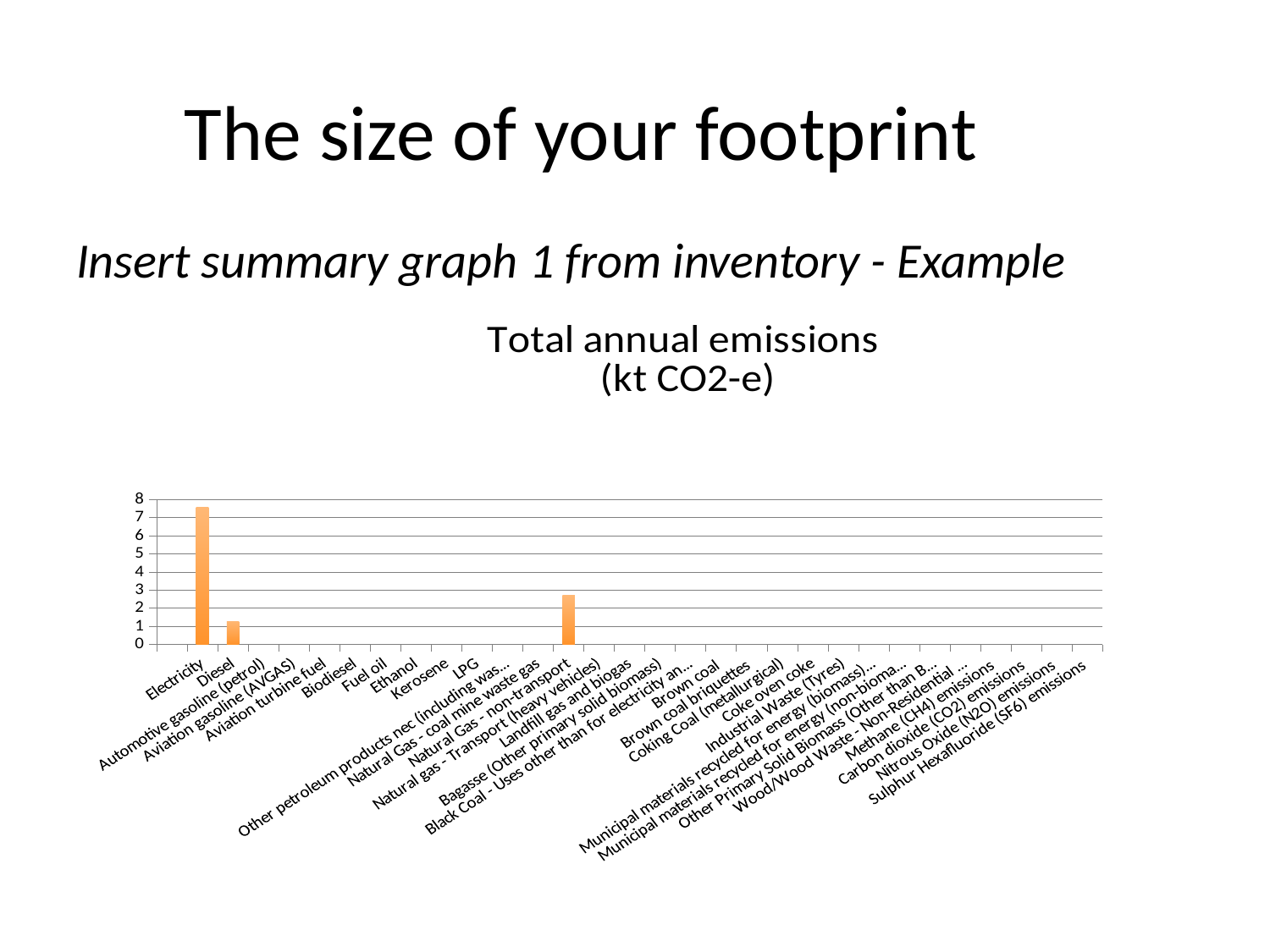
What is the highest value shown on the vertical axis? 8 What is the title of the chart? Total annual emissions (kt CO2-e) Is the value for Electricity greater or less than 7? greater Which is larger, the value for Natural Gas - non-transport or the value for Diesel? Natural Gas - non-transport How many categories show a visible non-zero bar? 3 Which category has the highest total annual emissions? Electricity Is the value for Natural Gas - non-transport greater or less than 3? less Is the value for Natural Gas - non-transport greater or less than 2? greater Which is larger, the value for Electricity or the value for Diesel? Electricity Which is larger, the value for Electricity or the value for Natural Gas - non-transport? Electricity What kind of chart is shown on the slide? bar chart